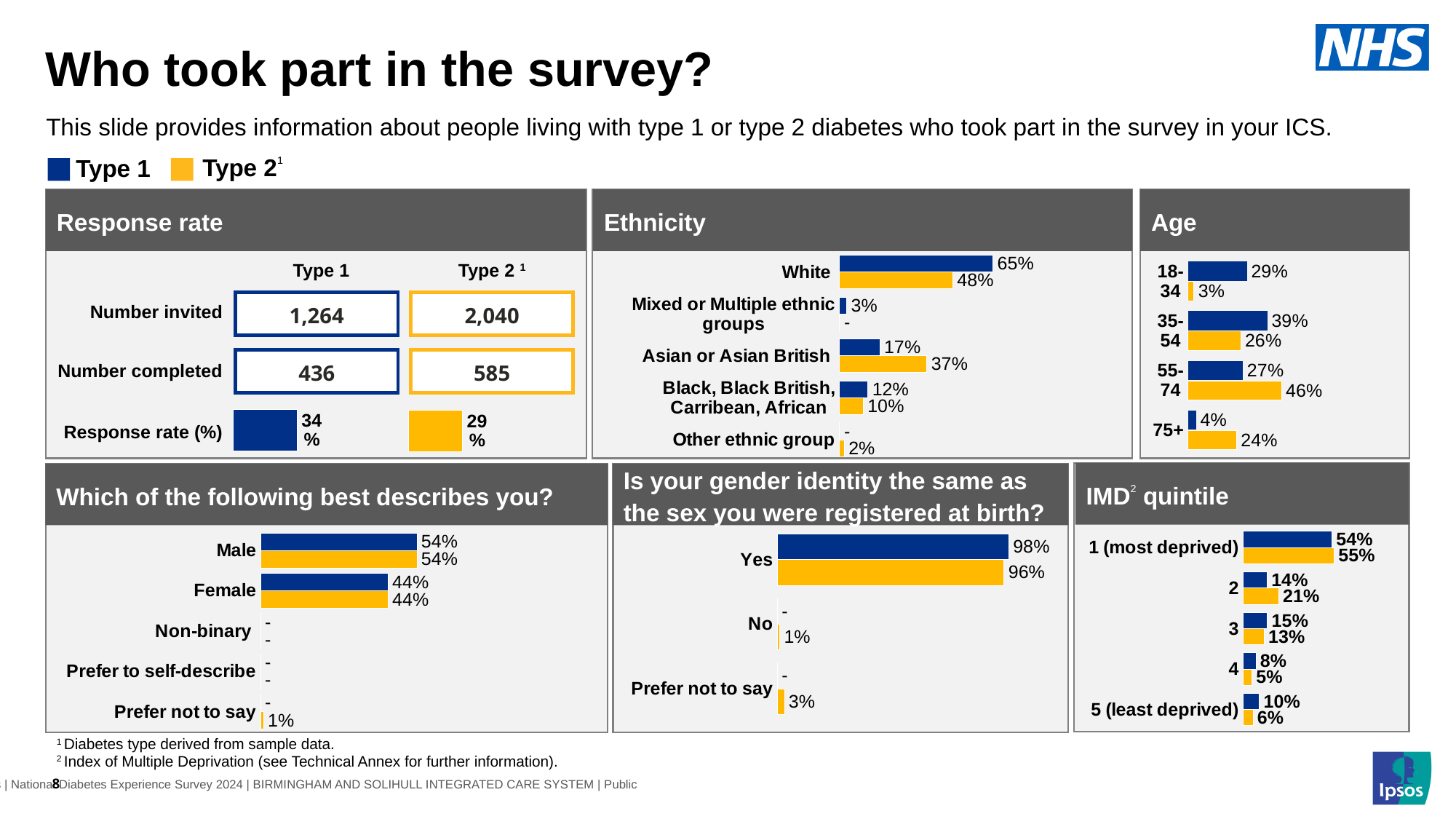
In the Ethnicity chart, what is the Type 2 value for Asian or Asian British? 37% How many series does the legend at the top of the slide list? 2 In the Ethnicity chart, how many ethnic group categories are shown? 5 In the IMD quintile chart, what is the Type 2 value for quintile 2? 21% In the chart 'Which of the following best describes you?', is the Type 1 value larger for Male or Female? Male In the chart 'Is your gender identity the same as the sex you were registered at birth?', what is the Type 1 value for Yes? 98% In the Response rate panel, what is the number completed for Type 2? 585 In the Age chart, what is the difference between the Type 2 and Type 1 values for 75+? 20 percentage points In the IMD quintile chart, which quintile has the lowest Type 1 value? 4 In the Ethnicity chart, what is the Type 1 value for White? 65% In the Age chart, which age group has the highest Type 2 value? 55-74 In the Response rate panel, what is the response rate for Type 1? 34%